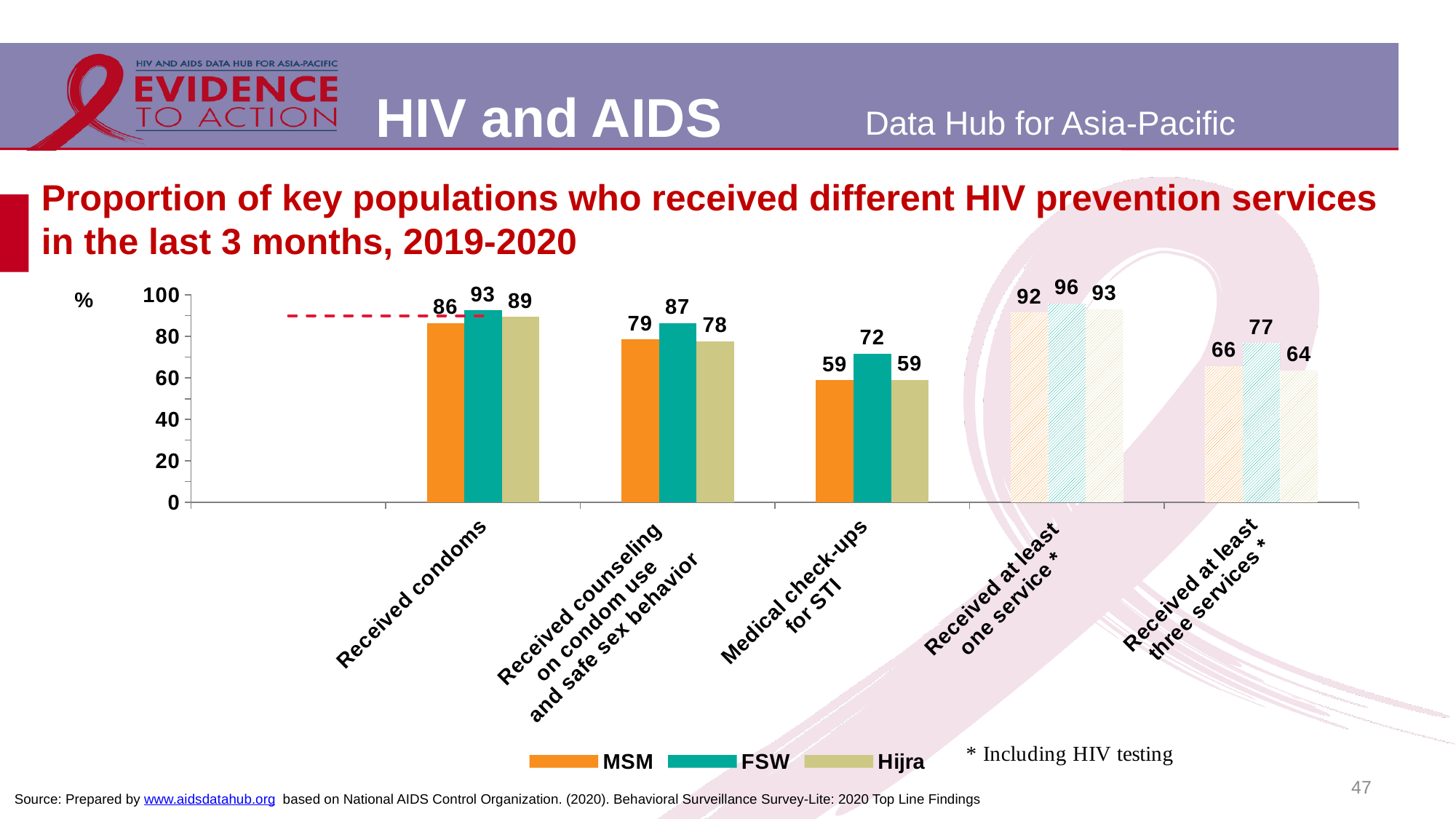
Which is larger in the 'Received at least three services *' category: the value for MSM or the value for Hijra? MSM What kind of chart is shown on the slide? Bar chart How many categories are shown on the x axis? 5 What is the value for Hijra in the 'Received at least one service *' category? 93 Which category has the lowest value for MSM? Medical check-ups for STI What is the value for FSW in the 'Received condoms' category? 93 What is the difference between the FSW and MSM values in the 'Received counseling on condom use and safe sex behavior' category? 8 What is the value for MSM in the 'Medical check-ups for STI' category? 59 Which category has the highest value for FSW? Received at least one service * Which series is shown in orange in the legend? MSM What is the value for Hijra in the 'Received at least three services *' category? 64 How many series does the legend list? 3